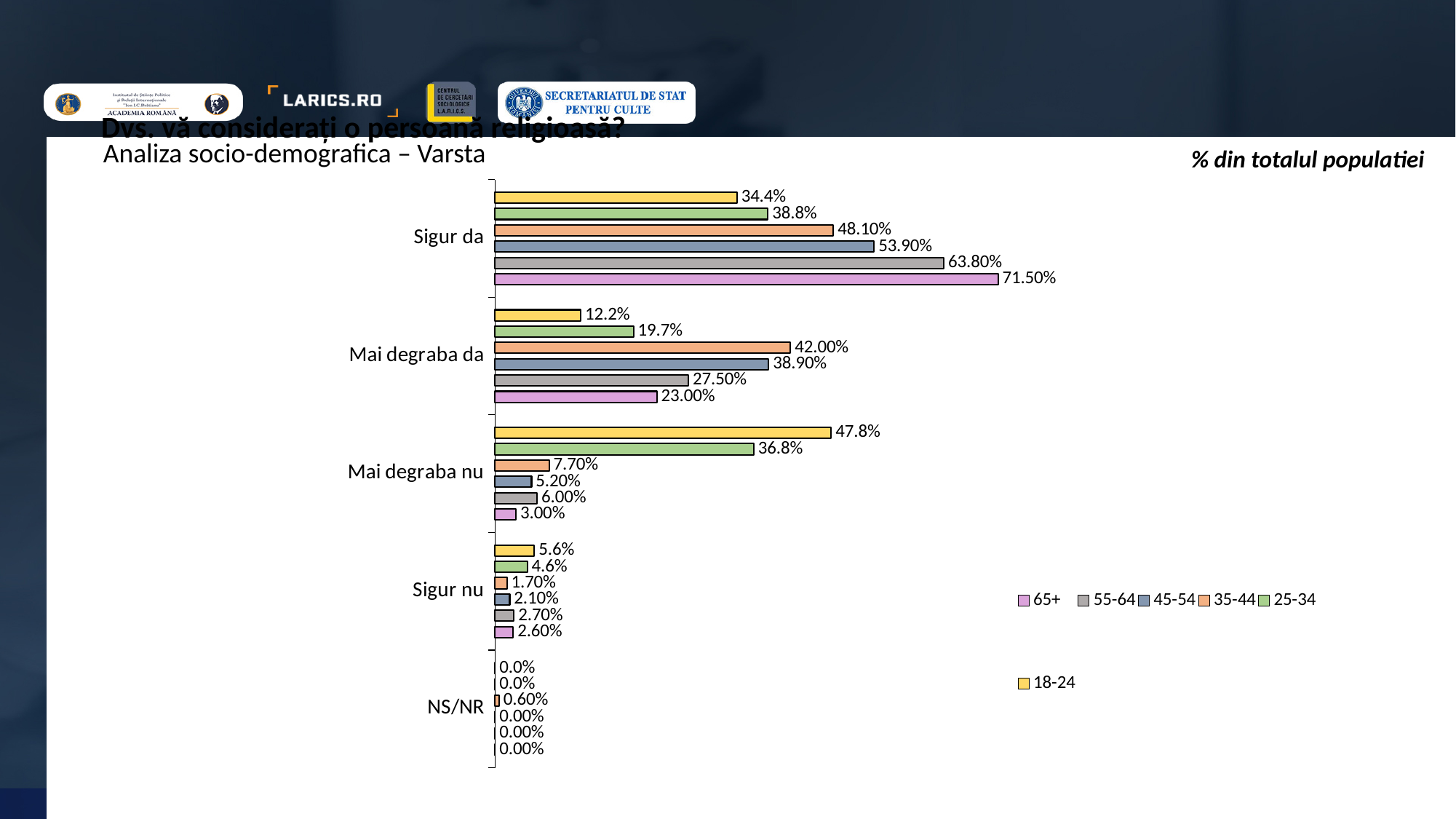
How many response categories are shown on the chart? 5 Which age group has the highest value in the "Sigur da" category? 65+ What is the difference between the 65+ and 18-24 values in the "Sigur da" category? 37.1% Which age group is the only one with a non-zero value in the "NS/NR" category? 35-44 What is the value for the 35-44 age group in the "Mai degraba da" category? 42.00% What is the value for the 55-64 age group in the "Sigur nu" category? 2.70% In the "Mai degraba da" category, which is larger: the value for 35-44 or the value for 45-54? 35-44 Which age group has the lowest value in the "Mai degraba nu" category? 65+ What is the value for the 65+ age group in the "Sigur da" category? 71.50% How many age groups does the legend list? 6 What is the value for the 18-24 age group in the "Mai degraba nu" category? 47.8% What kind of chart is shown on the slide? Bar chart